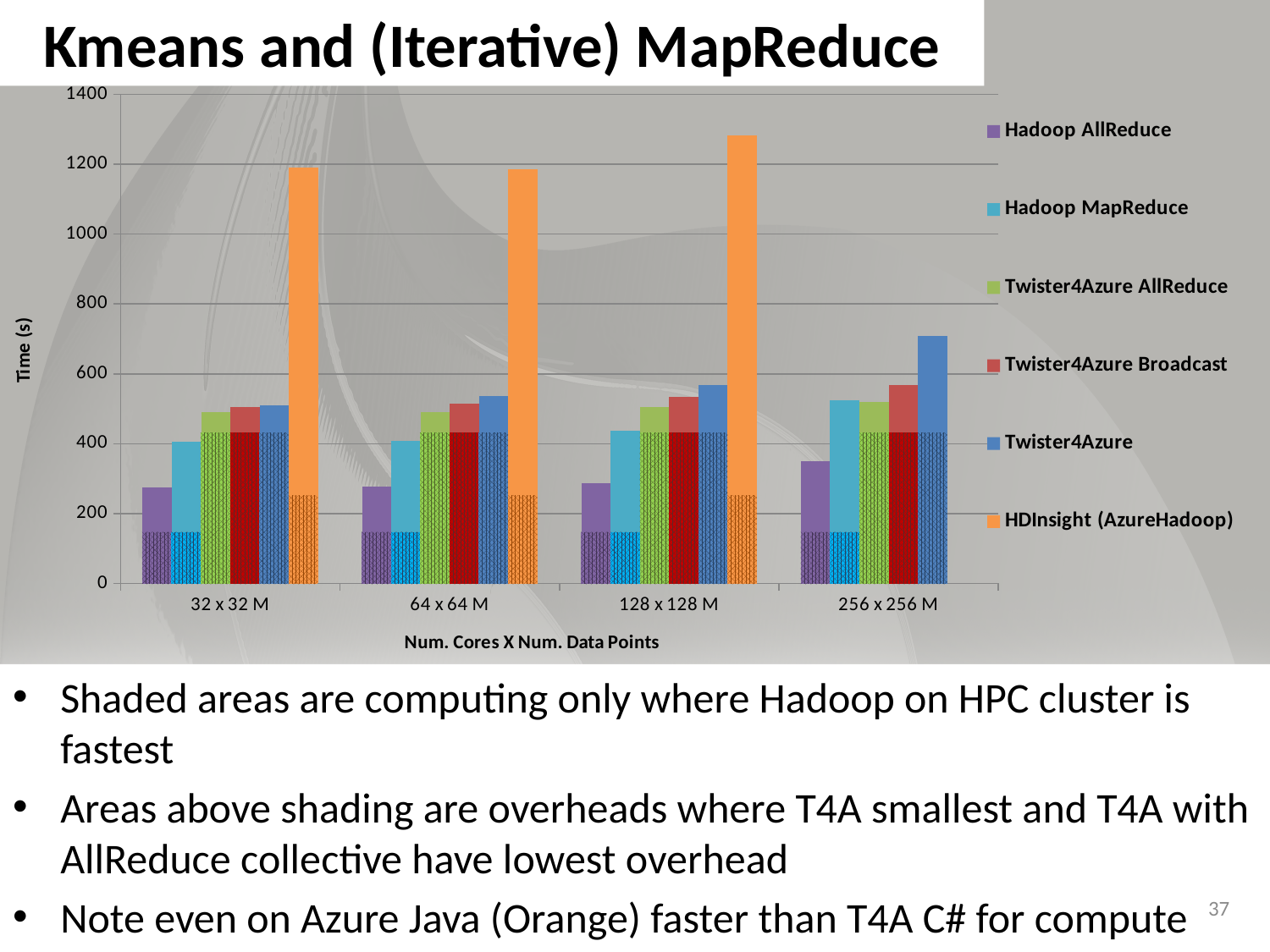
Which series has the lowest value for the 256 x 256 M category? Hadoop AllReduce Is the value for HDInsight (AzureHadoop) at 128 x 128 M greater or less than 1200? greater What kind of chart is shown on the slide? bar chart How many series does the chart's legend list? 6 What is the title of the chart's x axis? Num. Cores X Num. Data Points For the 64 x 64 M category, which is larger: Hadoop MapReduce or Hadoop AllReduce? Hadoop MapReduce Is the value for Twister4Azure at 256 x 256 M greater or less than 600? greater What is the title of the chart's y axis? Time (s) Do the values for Twister4Azure rise or fall from 32 x 32 M to 256 x 256 M? rise How many categories are shown on the x axis of the chart? 4 Is the value for Hadoop AllReduce at 32 x 32 M greater or less than 400? less Which series has the highest value for the 32 x 32 M category? HDInsight (AzureHadoop)